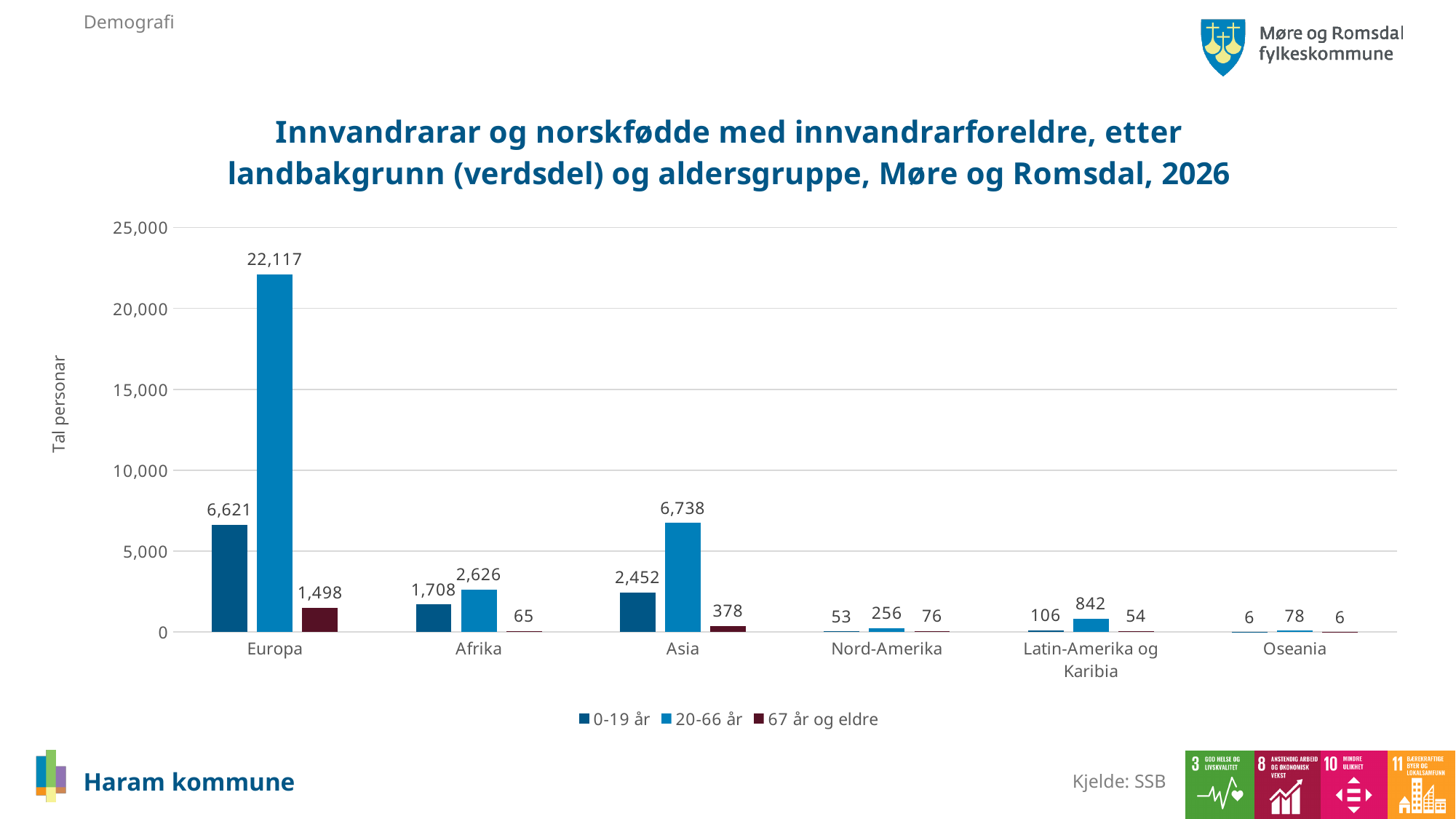
Which category has the lowest value for the 0-19 år series? Oseania How many categories are shown on the x axis? 6 What is the label of the y axis? Tal personar What is the value for the 0-19 år series for Latin-Amerika og Karibia? 106 Which category has the highest value for the 20-66 år series? Europa Which is larger for Afrika: the 0-19 år value or the 20-66 år value? 20-66 år How many series does the legend list? 3 What is the value for the 67 år og eldre series for Asia? 378 Is the value for the 0-19 år series for Europa greater or less than 5,000? greater What kind of chart is shown on the slide? Bar chart What is the value for the 20-66 år series for Europa? 22,117 What is the difference between the 20-66 år and 0-19 år values for Asia? 4,286